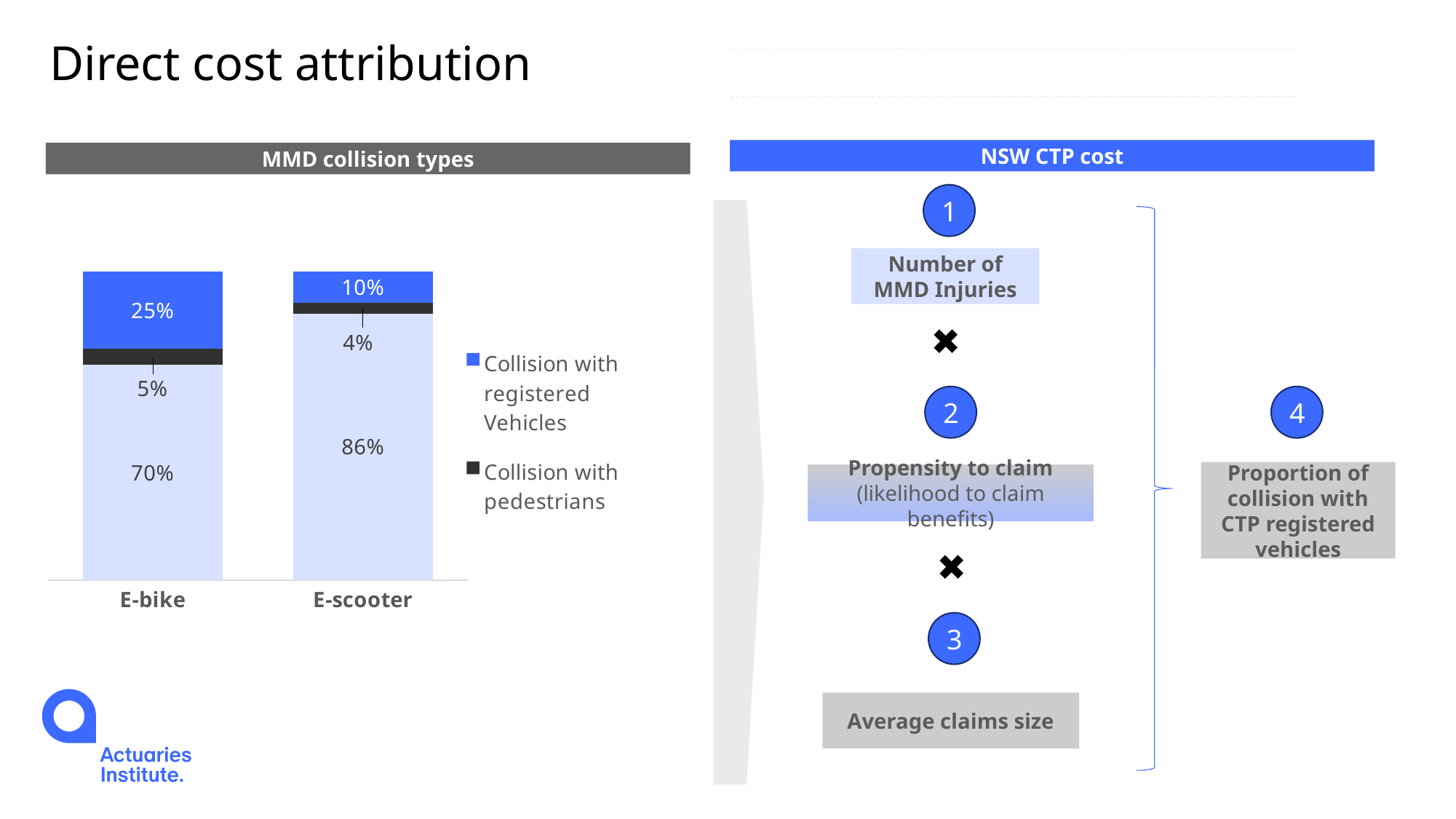
What percentage of E-scooter MMD collisions are collisions with registered vehicles? 10% What percentage of E-bike MMD collisions are collisions with registered vehicles? 25% Which category has the higher share of collisions with registered vehicles, E-bike or E-scooter? E-bike How many categories are shown on the x axis of the MMD collision types chart? 2 What percentage of E-bike MMD collisions are collisions with pedestrians? 5% What is the value of the largest (bottom) segment of the E-bike bar? 70% What is the difference between the E-bike and E-scooter shares of collisions with registered vehicles? 15% What is the difference between the E-scooter and E-bike bottom segment values (86% and 70%)? 16% How many series does the legend of the MMD collision types chart list? 2 What type of chart is the MMD collision types chart? Stacked bar chart What is the value of the largest (bottom) segment of the E-scooter bar? 86% What percentage of E-scooter MMD collisions are collisions with pedestrians? 4%